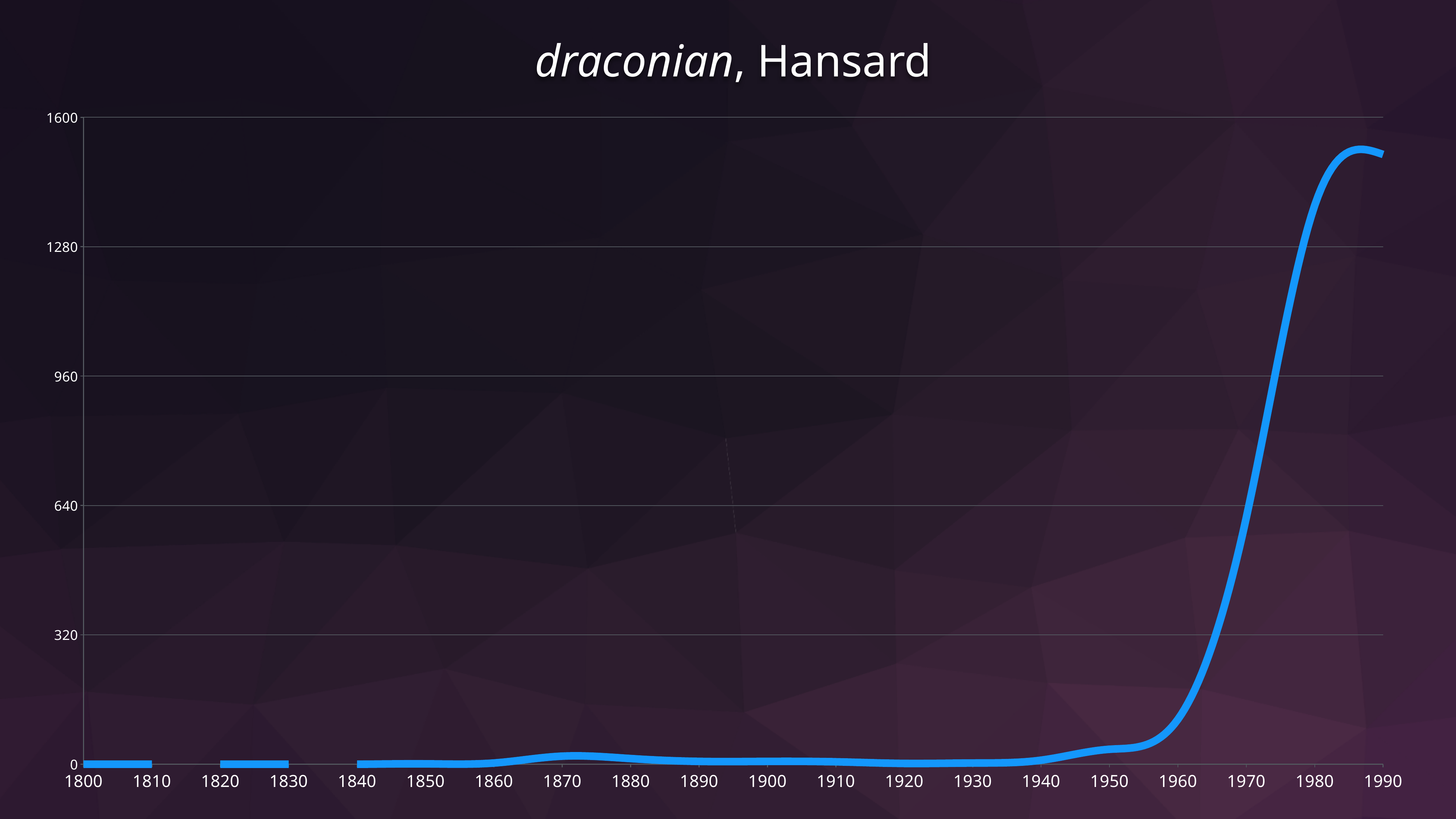
Which has the larger value, 1800 or 1990? 1990 Overall, do the values rise or fall from 1950 to 1990? rise Is the value for 1980 greater or less than 960? greater What kind of chart is shown on the slide? line chart Is the value for 1990 greater or less than 1280? greater What is the title of the chart? draconian, Hansard Is the value for 1900 greater or less than 320? less How many year labels are shown on the x axis? 20 Which has the larger value, 1970 or 1960? 1970 Which of the labelled years on the x axis has the highest value? 1990 What is the highest value labelled on the y axis? 1600